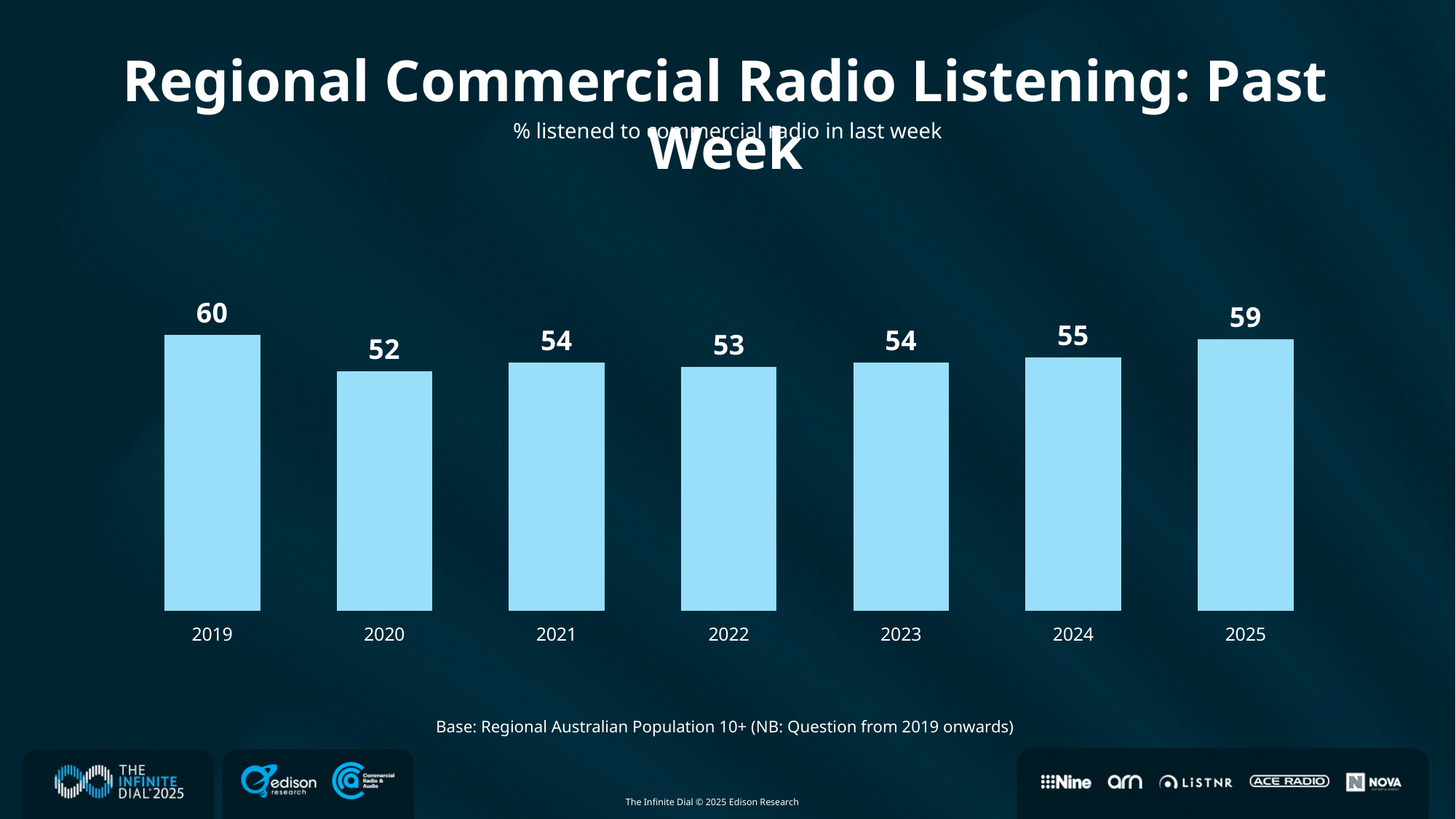
Which year has the highest value? 2019 What is the subtitle of the chart? % listened to commercial radio in last week Which year has the lowest value? 2020 What is the value for 2022? 53 What kind of chart is shown on the slide? bar chart What is the value for 2019? 60 What is the value for 2025? 59 What is the difference between the values for 2025 and 2024? 4 Which is larger, the value for 2021 or the value for 2022? 2021 Do the values rise or fall from 2020 to 2025? rise How many years are shown on the chart? 7 What is the difference between the values for 2019 and 2020? 8